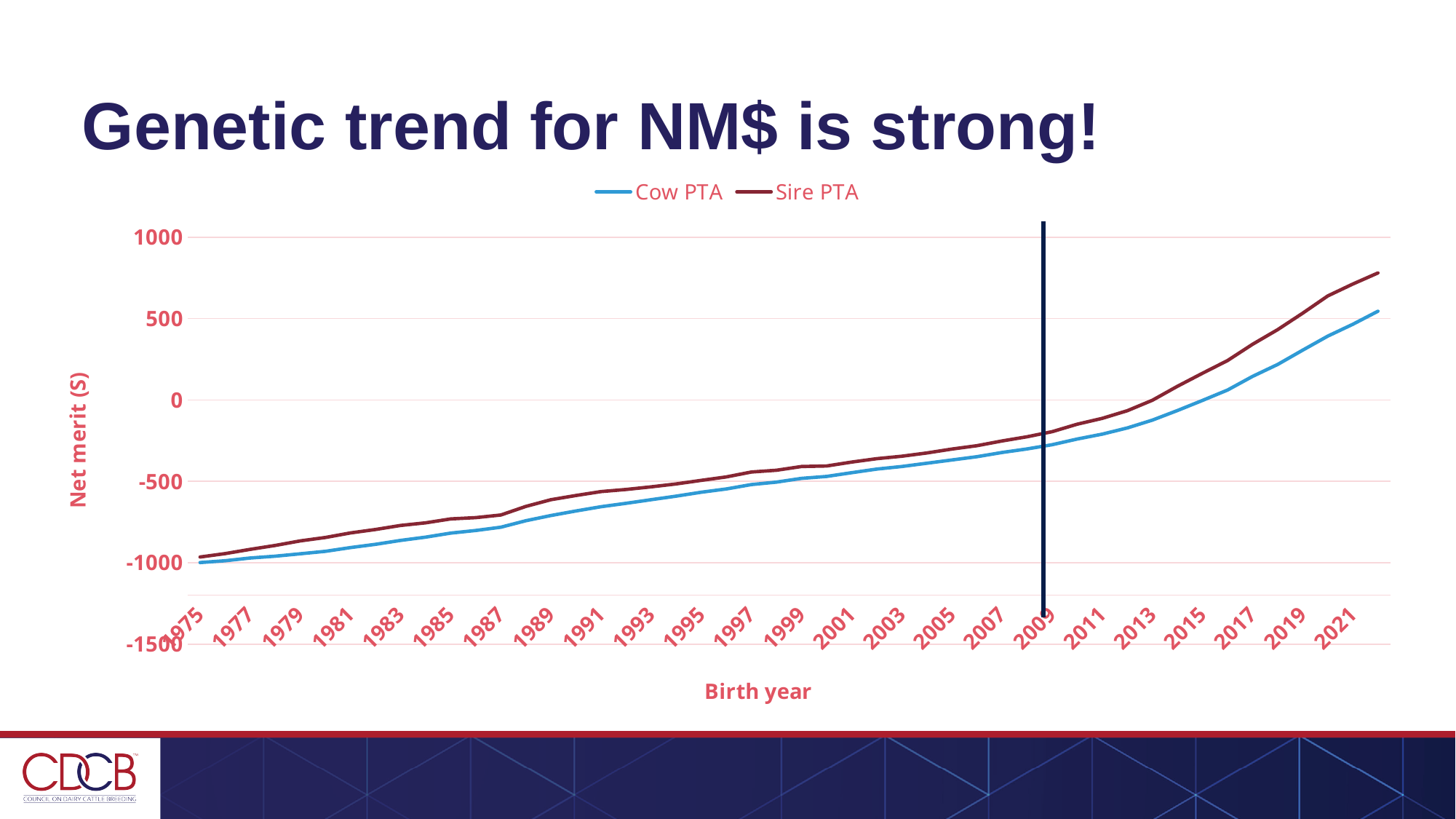
Is the Sire PTA value for 2021 greater or less than 500? greater Do the Cow PTA values rise or fall as birth year increases from 1975 to 2021? Rise What is the label of the y axis? Net merit ($) Which series is higher in 2021, Cow PTA or Sire PTA? Sire PTA How many series does the legend list? 2 What are the two series named in the legend? Cow PTA and Sire PTA Is the Cow PTA value for 1975 greater or less than -500? less How many birth-year labels are shown on the x axis? 24 Is the Cow PTA value for 2019 greater or less than 0? greater What kind of chart is shown on the slide? Line chart